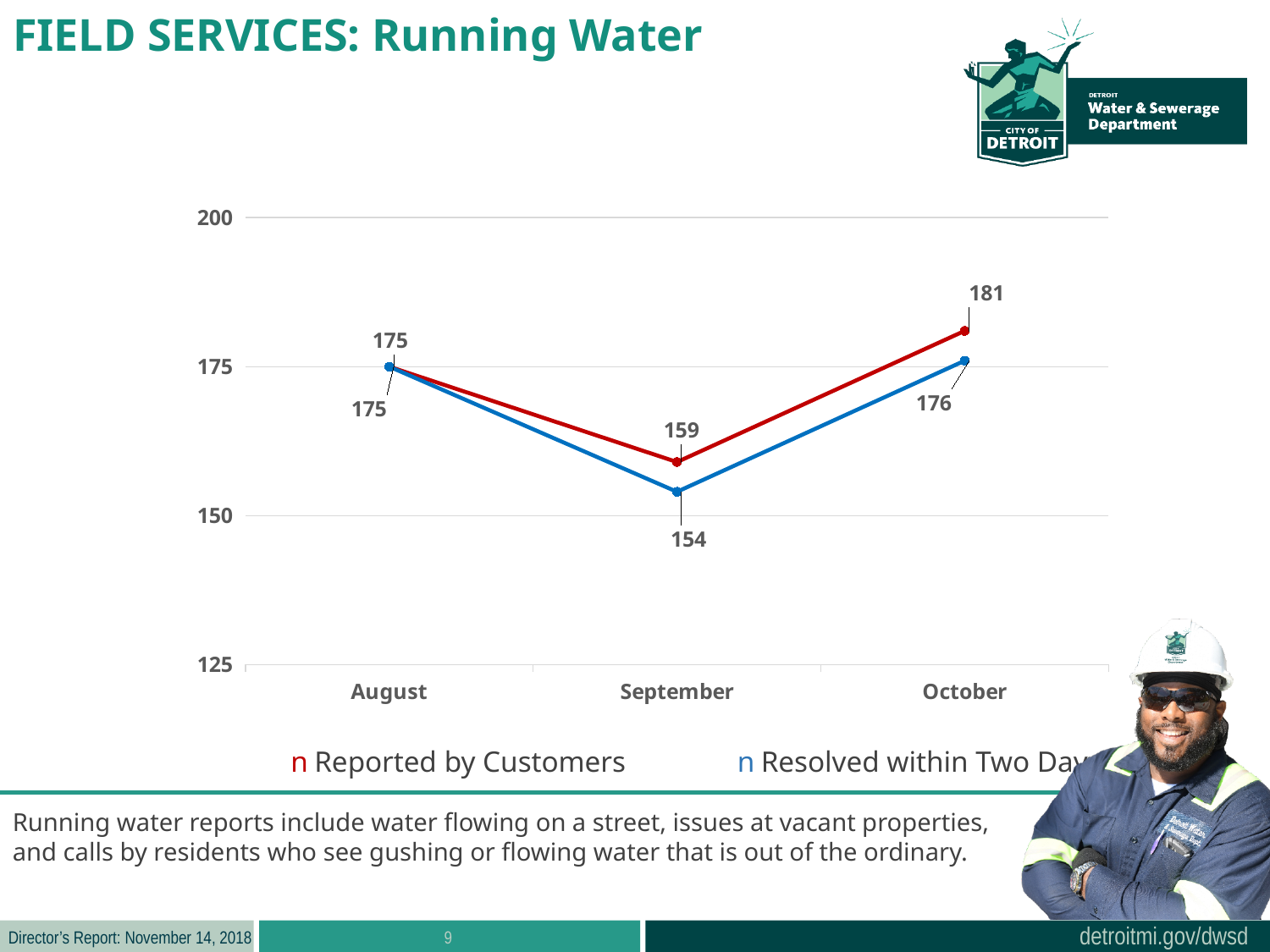
In which month is the Resolved within Two Days value lowest? September In September, which is larger: Reported by Customers or Resolved within Two Days? Reported by Customers What is the difference between Reported by Customers and Resolved within Two Days in October? 5 How many series does the chart's legend list? 2 What is the value for Reported by Customers in September? 159 What is the value for Resolved within Two Days in October? 176 In which month is the Reported by Customers value highest? October Which colour is used for the Reported by Customers line? Red What type of chart is shown on the slide? Line chart How many months are plotted along the x axis? 3 What is the value for Reported by Customers in October? 181 What is the value for Resolved within Two Days in September? 154